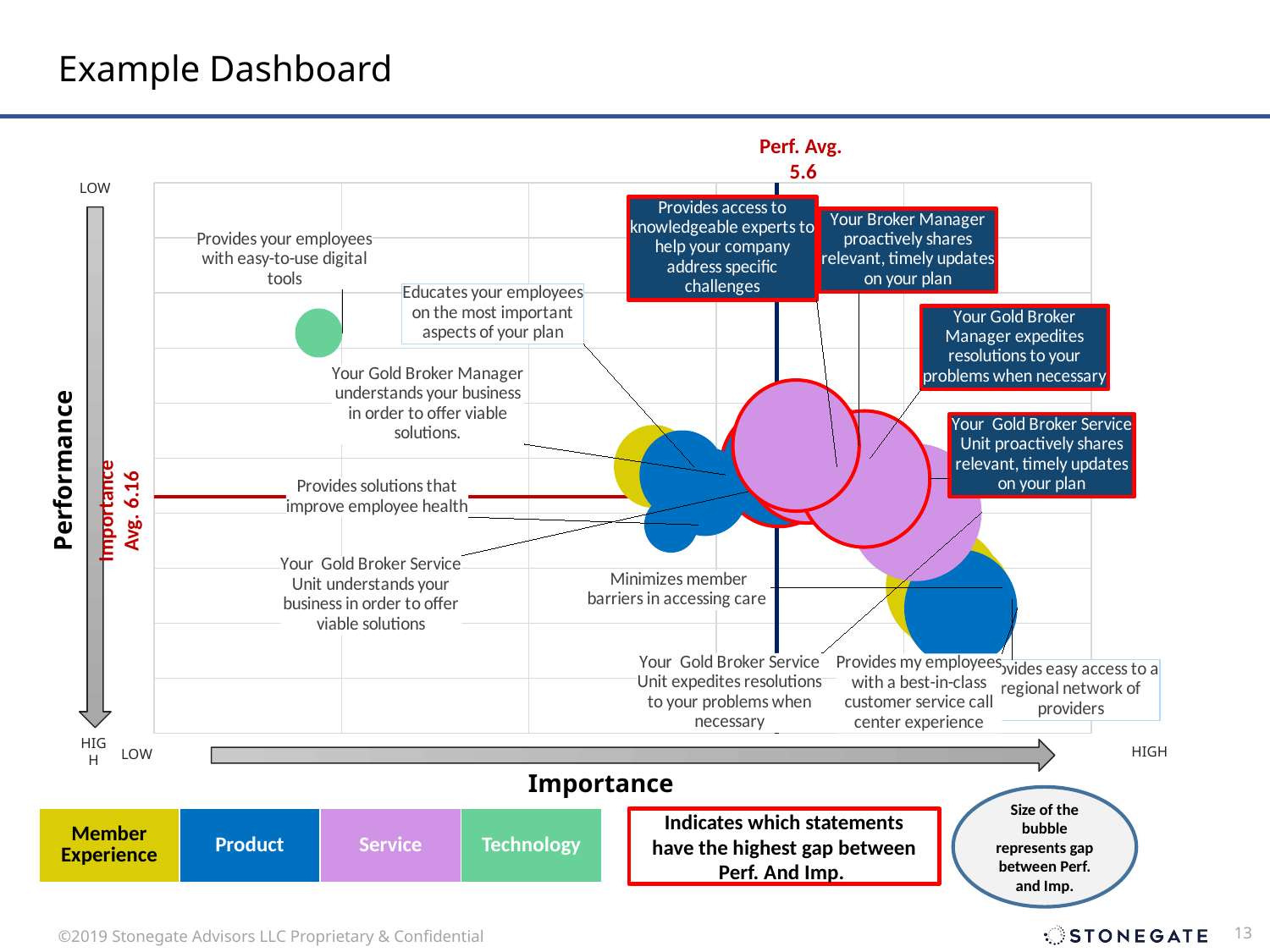
Which legend category is shown in green? Technology What is the Importance average value printed on the chart? 6.16 What is the title of the slide containing the chart? Example Dashboard According to the slide, what does the size of a bubble represent? Gap between Perf. and Imp. What is the Performance average value printed on the chart? 5.6 What kind of chart is shown on the slide? Bubble chart Which statement is plotted as the green bubble on the chart? Provides your employees with easy-to-use digital tools How many categories does the legend at the bottom of the chart list? 4 Which of the two printed averages is larger, the Performance average or the Importance average? Importance average